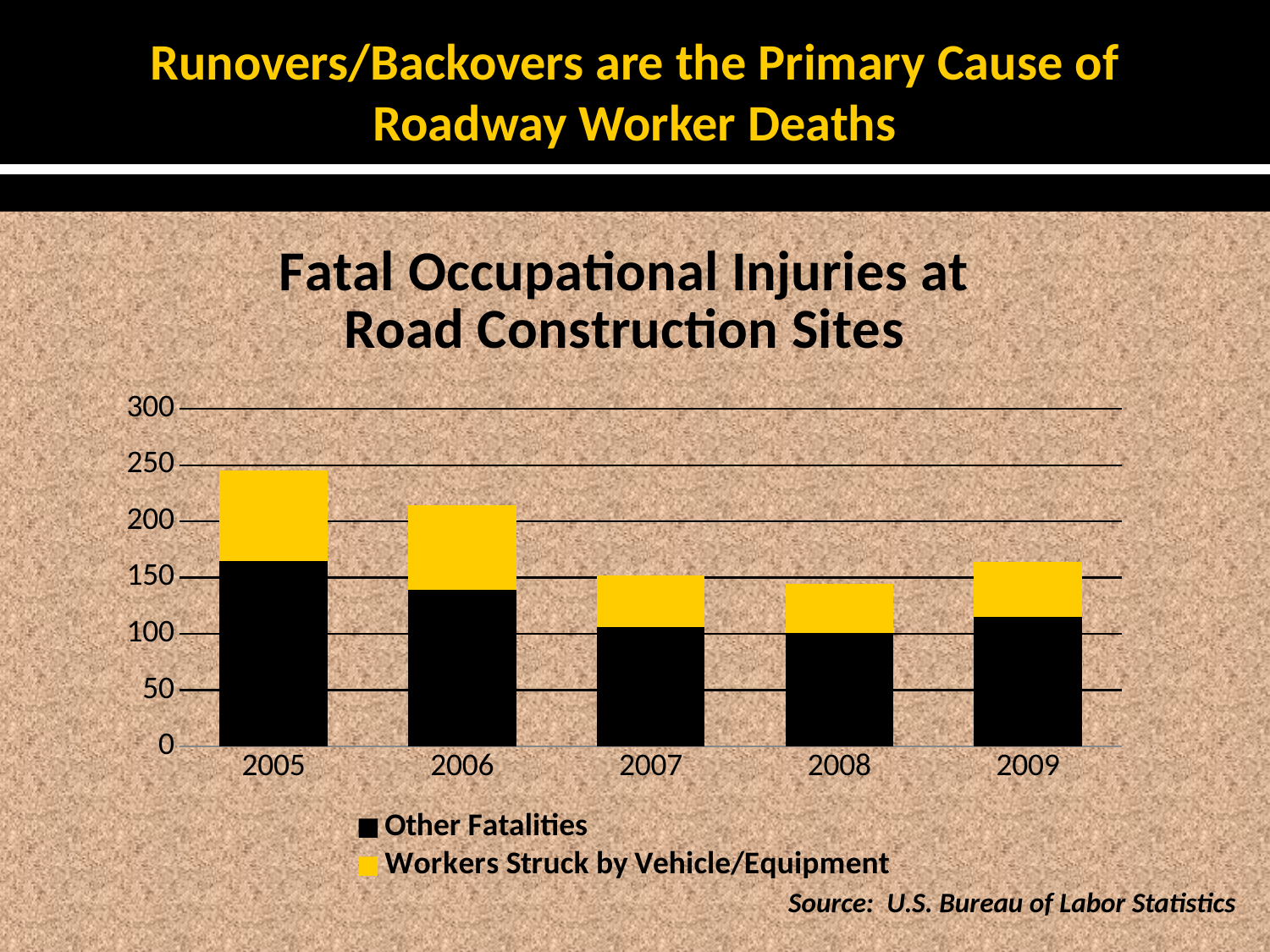
From 2005 to 2008, do the total bars rise or fall? fall Is the Other Fatalities value for 2005 greater or less than 150? greater Which colour represents Workers Struck by Vehicle/Equipment in the chart? Yellow Is the Other Fatalities value for 2006 greater or less than 150? less Which year has the highest total bar in the chart? 2005 How many years are shown on the x axis of the chart? 5 Is the total bar for 2005 greater or less than 200? greater What kind of chart is shown on the slide? Stacked bar chart Which year has the larger total bar, 2005 or 2009? 2005 How many series does the chart's legend list? 2